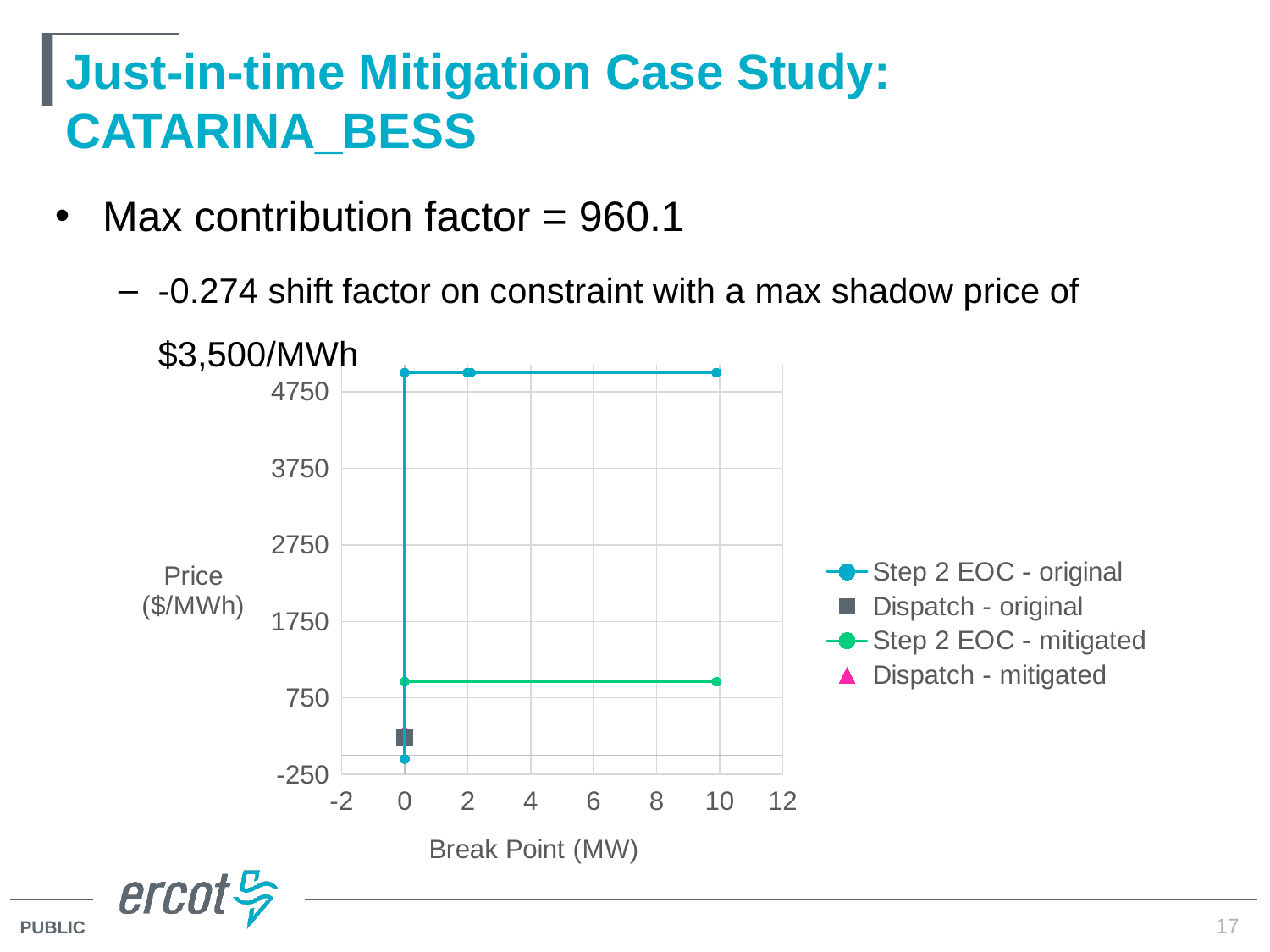
How many series does the chart legend list? 4 What is the title of the x axis of the chart? Break Point (MW) Does the Step 2 EOC - mitigated price rise, fall, or stay flat as the break point increases from 0 to 10 MW? Stays flat At a break point of 10 MW, which series has the higher price: Step 2 EOC - original or Step 2 EOC - mitigated? Step 2 EOC - original What is the title of the y axis of the chart? Price ($/MWh) What kind of chart is shown on the slide? Line chart Is the price for the Step 2 EOC - mitigated series at a break point of 10 MW greater or less than 750? greater Which series has the highest price shown on the chart? Step 2 EOC - original Is the price for the Step 2 EOC - mitigated series at a break point of 10 MW greater or less than 1750? less Is the price for the Step 2 EOC - original series at a break point of 10 MW greater or less than 4750? greater